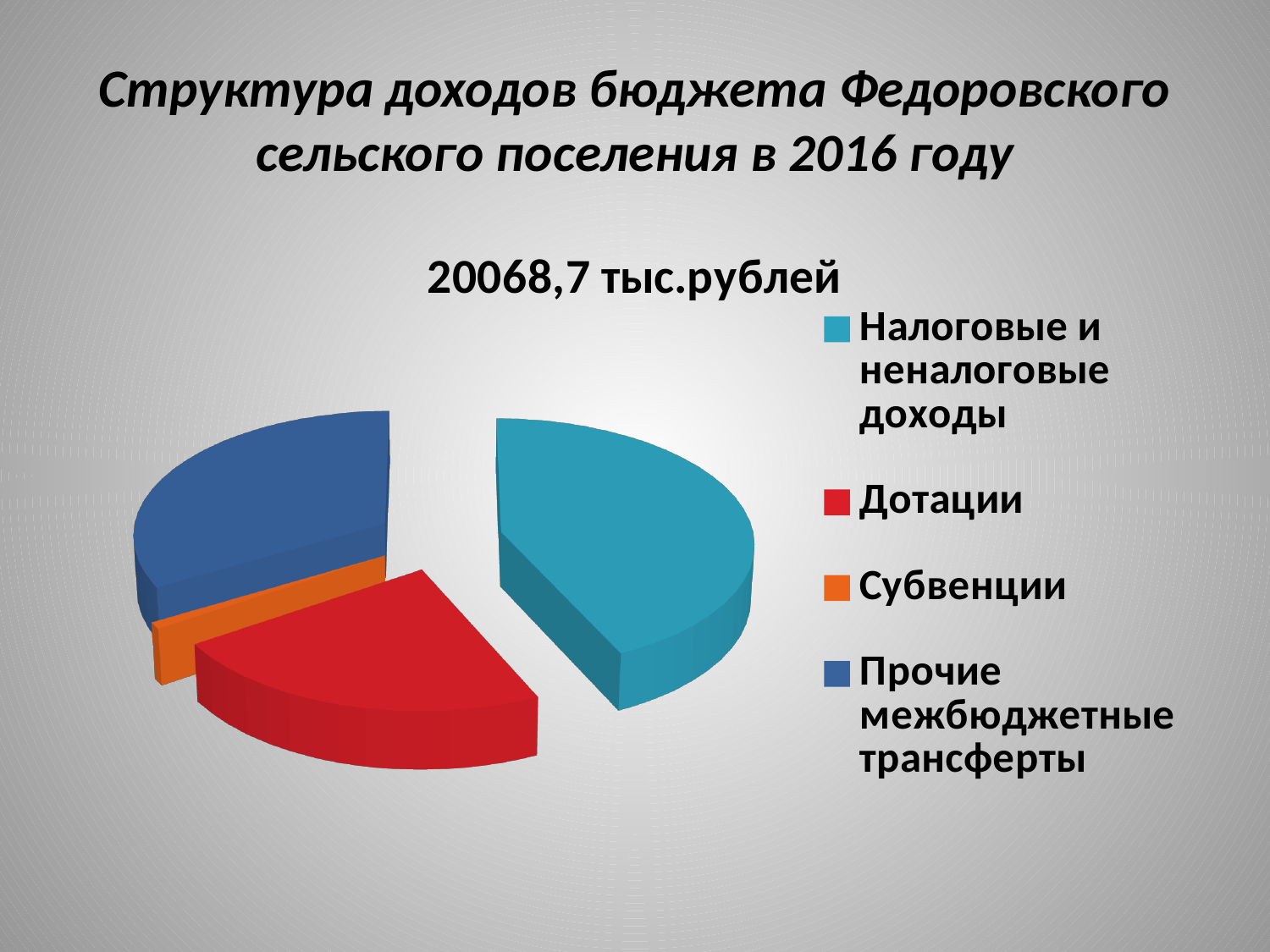
What colour is the slice for Дотации? red Which slice is larger: Прочие межбюджетные трансферты or Субвенции? Прочие межбюджетные трансферты What is the title shown above the pie chart? 20068,7 тыс.рублей Which slice is larger: Налоговые и неналоговые доходы or Дотации? Налоговые и неналоговые доходы How many entries does the legend list? 4 Which slice is larger: Дотации or Субвенции? Дотации What kind of chart is shown on the slide? pie chart How many slices does the pie chart have? 4 Which category has the smallest slice of the pie? Субвенции